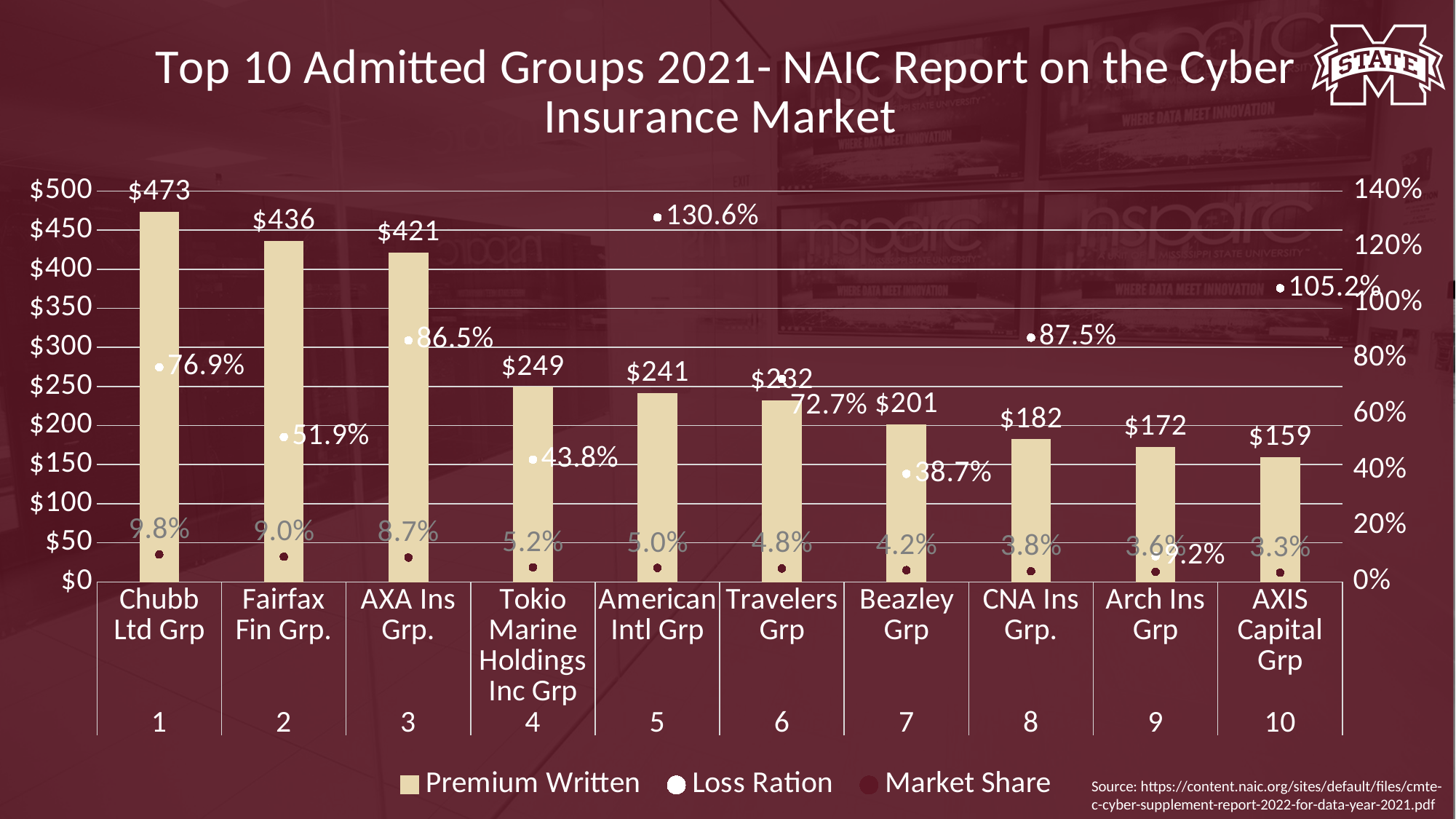
Which group has the highest Premium Written? Chubb Ltd Grp What is the Premium Written value for Chubb Ltd Grp? $473 How many groups are shown on the x axis? 10 What is the Market Share for Tokio Marine Holdings Inc Grp? 5.2% Which group has the highest Loss Ratio? American Intl Grp Do the Premium Written values rise or fall from left to right along the x axis? fall What is the Loss Ratio for American Intl Grp? 130.6% Which has the larger Premium Written, Beazley Grp or CNA Ins Grp.? Beazley Grp What is the difference in Premium Written between Chubb Ltd Grp and Fairfax Fin Grp.? $37 What kind of chart is used to show Premium Written? bar chart How many series does the legend list? 3 Which group has the lowest Premium Written? AXIS Capital Grp